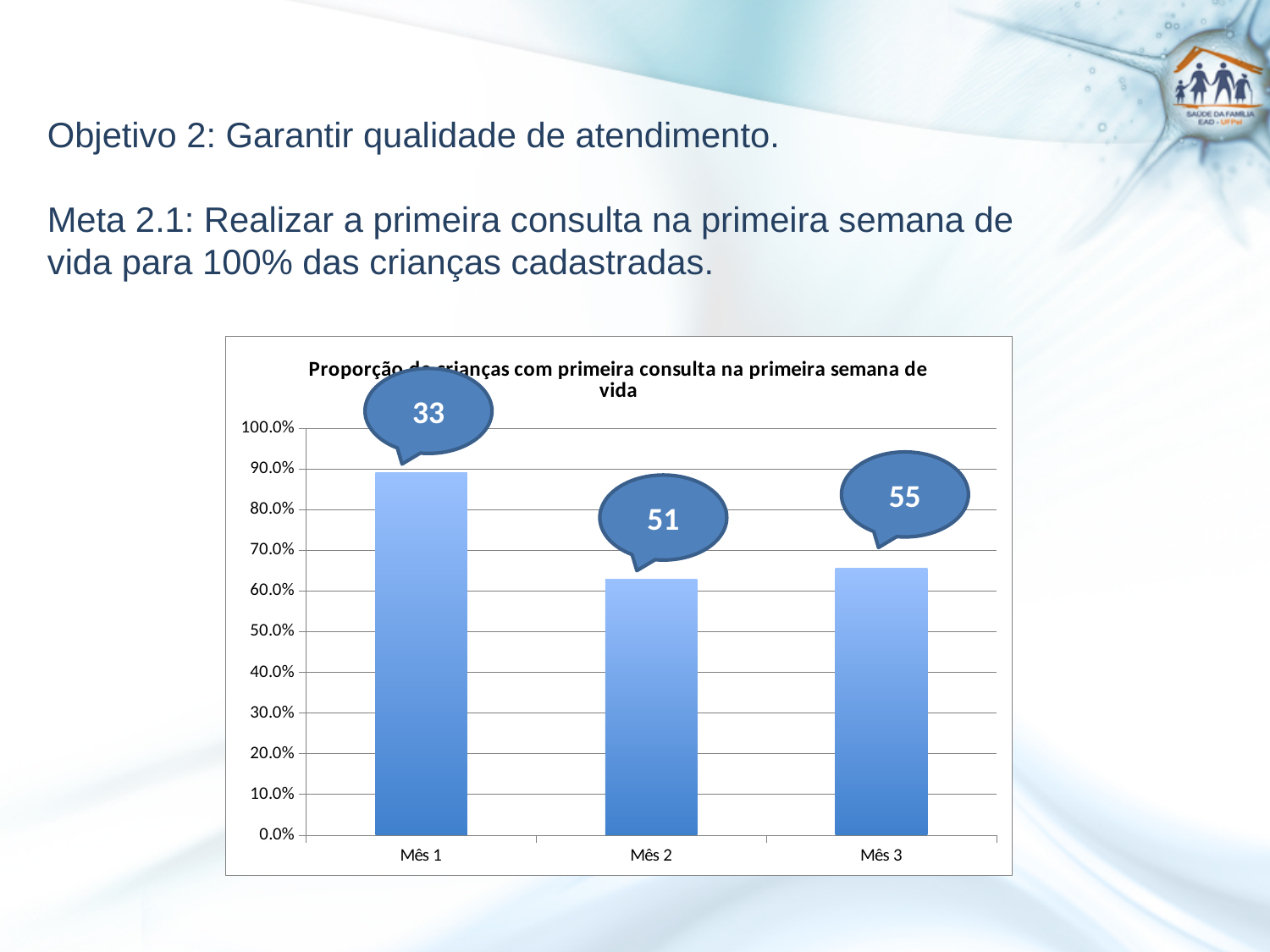
What kind of chart is shown on the slide? bar chart Is the value for Mês 3 greater or less than 60.0%? greater Which month has the highest proportion of children with a first consultation in the first week of life? Mês 1 What is the title of the chart? Proporção de crianças com primeira consulta na primeira semana de vida How many categories (months) are shown on the x axis of the chart? 3 Is the value for Mês 2 greater or less than 60.0%? greater Which is larger, the value for Mês 1 or the value for Mês 2? Mês 1 Is the value for Mês 2 greater or less than 70.0%? less Does the value rise or fall from Mês 1 to Mês 2? fall What number is shown in the callout above the Mês 2 bar? 51